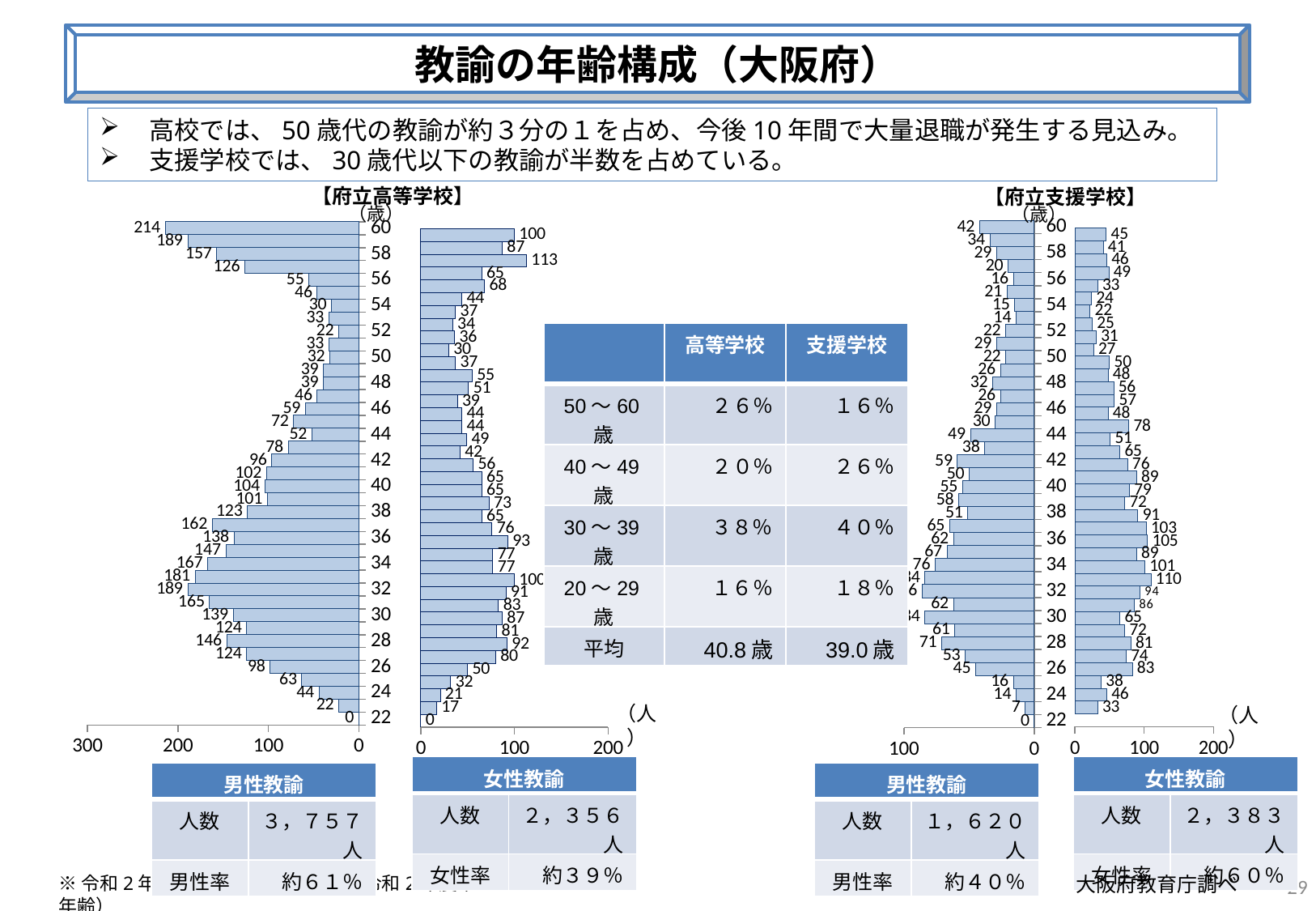
In the 府立高等学校 男性教諭 chart, what is the value for age 32? 189 In the 府立高等学校 男性教諭 chart, what is the difference between the values for age 60 and age 58? 57 In the 府立高等学校 男性教諭 chart, which age has the highest value? 60 In the 府立高等学校 女性教諭 chart, which age has the highest value? 58 In the 府立高等学校 男性教諭 chart, what is the value for age 60? 214 In the 府立支援学校 女性教諭 chart, what is the difference between the values for age 36 and age 37? 2 In the 府立高等学校 女性教諭 chart, what is the value for age 58? 113 What kind of chart is used to show the age composition of teachers on this slide? bar chart In the 府立高等学校 女性教諭 chart, is the value for age 36 greater or less than 100? less In the 府立支援学校 男性教諭 chart, what is the value for age 60? 42 In the 府立支援学校 男性教諭 chart, which is larger, the value for age 34 or the value for age 60? age 34 In the 府立支援学校 女性教諭 chart, what is the value for age 33? 110